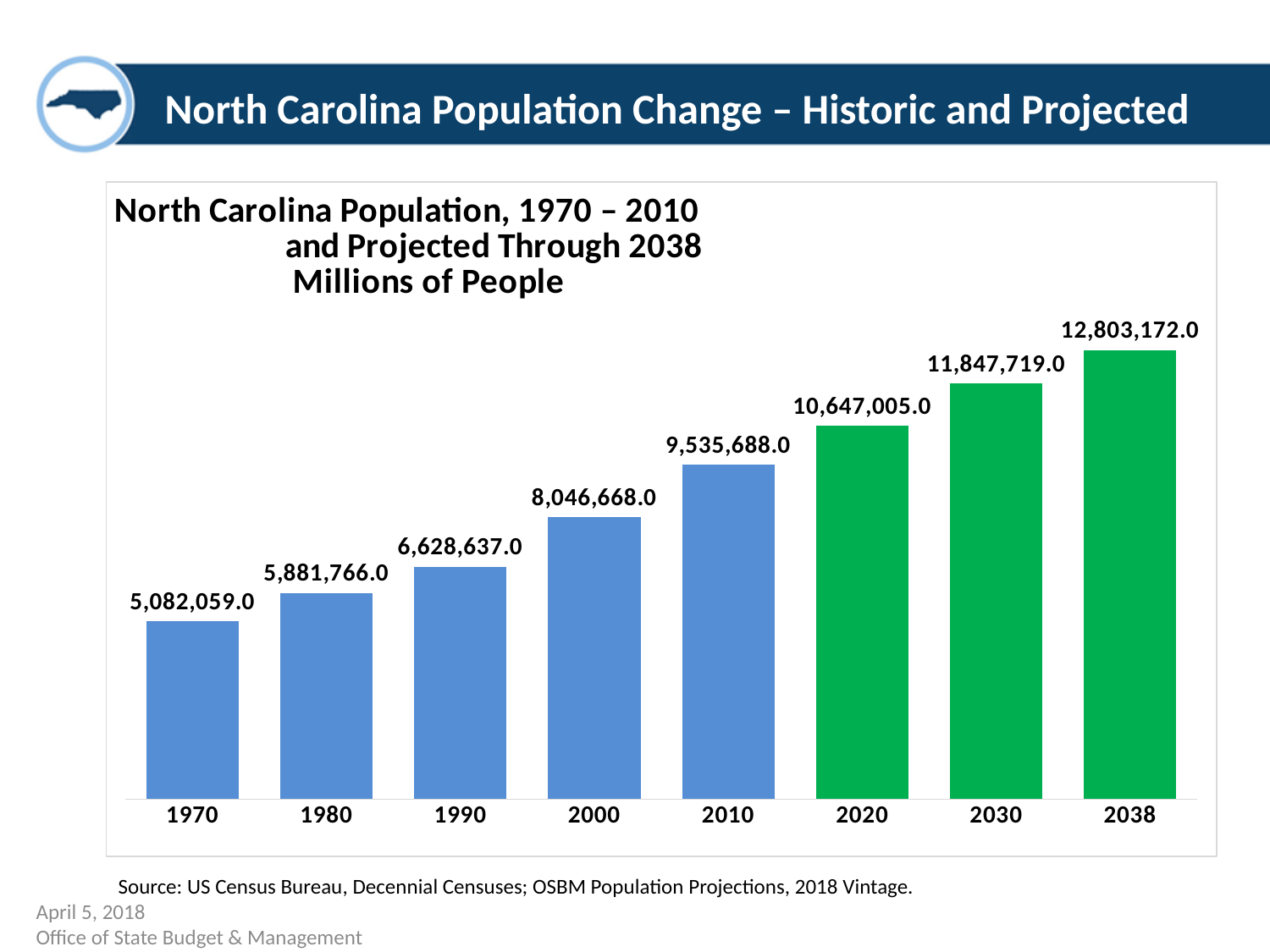
What kind of chart is shown on the slide? Bar chart Do the population values rise or fall from 1970 to 2038? Rise What is the population value shown for 1970? 5,082,059.0 Which year has the highest population value on the chart? 2038 What is the projected population shown for 2038? 12,803,172.0 How many years (bars) are shown on the chart? 8 What is the population value shown for 2000? 8,046,668.0 What colour are the bars for the projected years 2020, 2030 and 2038? Green What is the difference between the population values for 2010 and 2000? 1,489,020.0 What is the difference between the population values for 2038 and 1970? 7,721,113.0 Which is larger, the population value for 2020 or for 2010? 2020 Which year has the lowest population value on the chart? 1970